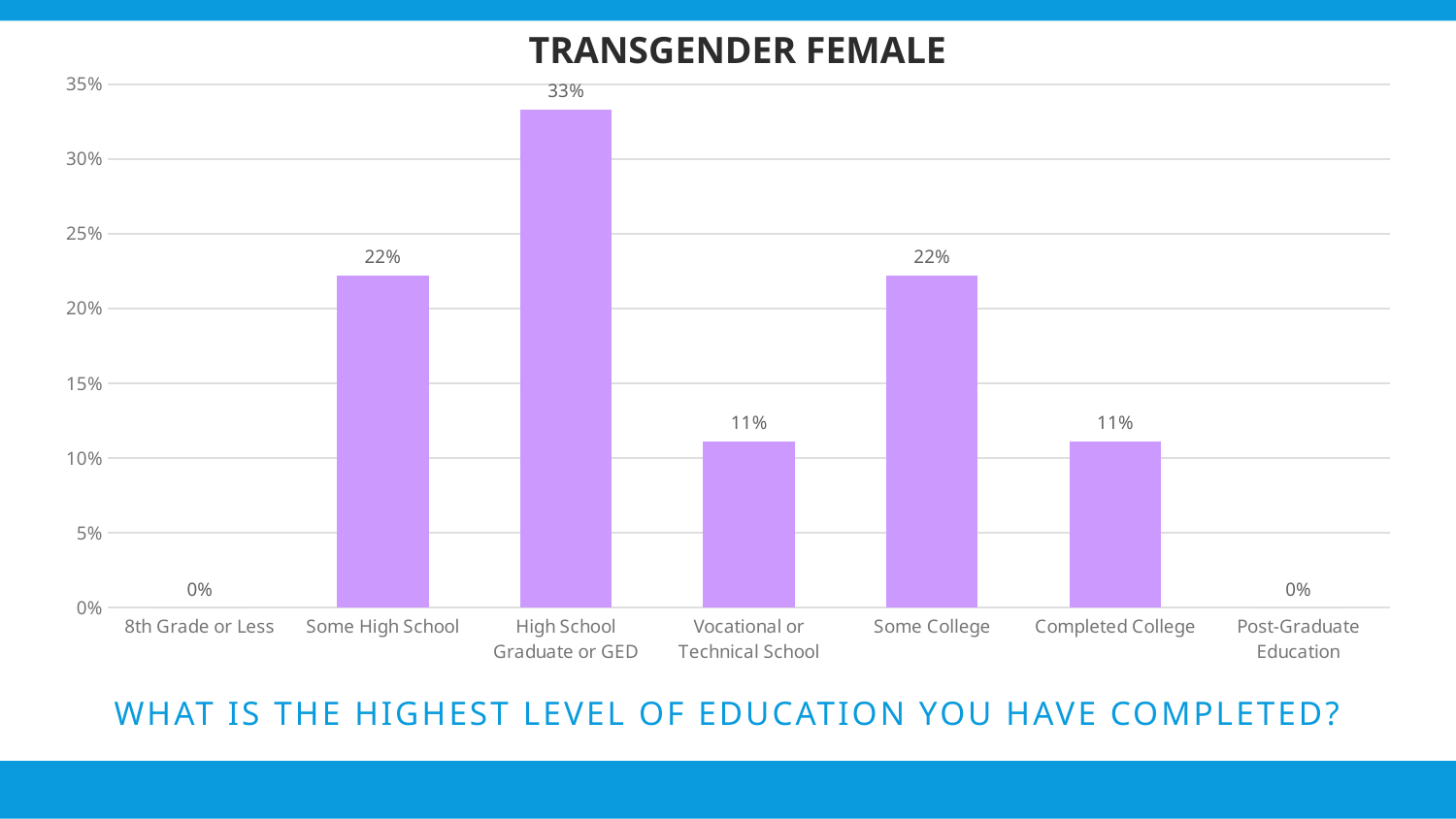
What is the title of the chart? TRANSGENDER FEMALE What is the difference between Some College and Completed College? 11% Which is larger, Some High School or Vocational or Technical School? Some High School What is the difference between High School Graduate or GED and Some High School? 11% What kind of chart is shown on the slide? bar chart Is the value for High School Graduate or GED greater or less than 30%? greater What is the value for Some College? 22% What is the value for Vocational or Technical School? 11% What is the value for Post-Graduate Education? 0% How many categories are shown on the x axis? 7 Which category has the highest value? High School Graduate or GED What is the value for High School Graduate or GED? 33%